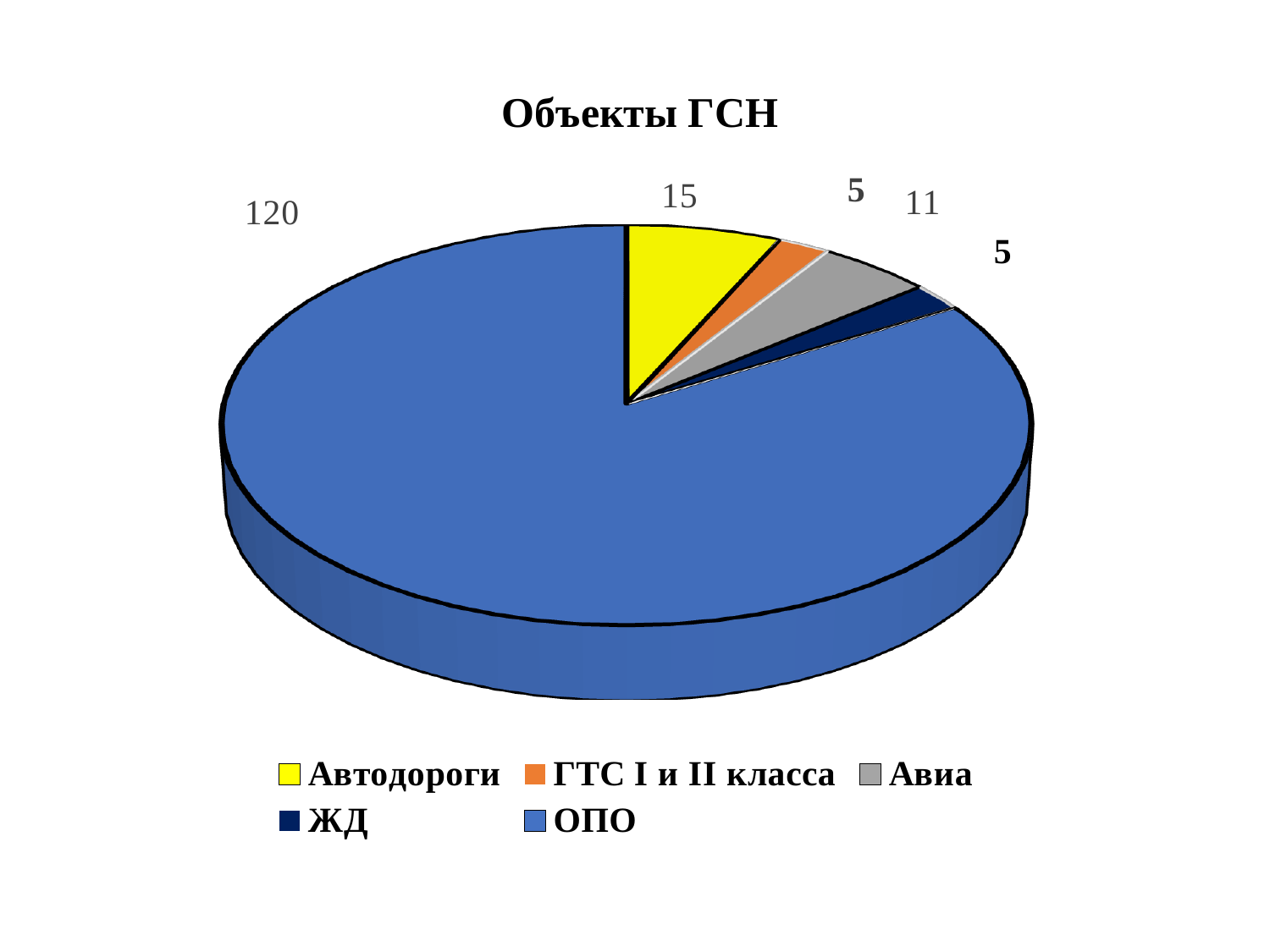
What type of chart is shown on the slide? Pie chart What is the total of all the slice values in the pie chart? 156 What is the value of the Автодороги slice? 15 What is the value of the ЖД slice? 5 Which two categories share the smallest value in the pie chart? ГТС I и II класса and ЖД What is the value of the ОПО slice in the pie chart? 120 What is the value of the Авиа slice? 11 What is the difference between the ОПО value and the Автодороги value? 105 What is the title of the chart? Объекты ГСН Which category has the largest slice in the pie chart? ОПО How many categories does the pie chart show? 5 Which is larger, the Авиа slice or the Автодороги slice? Автодороги